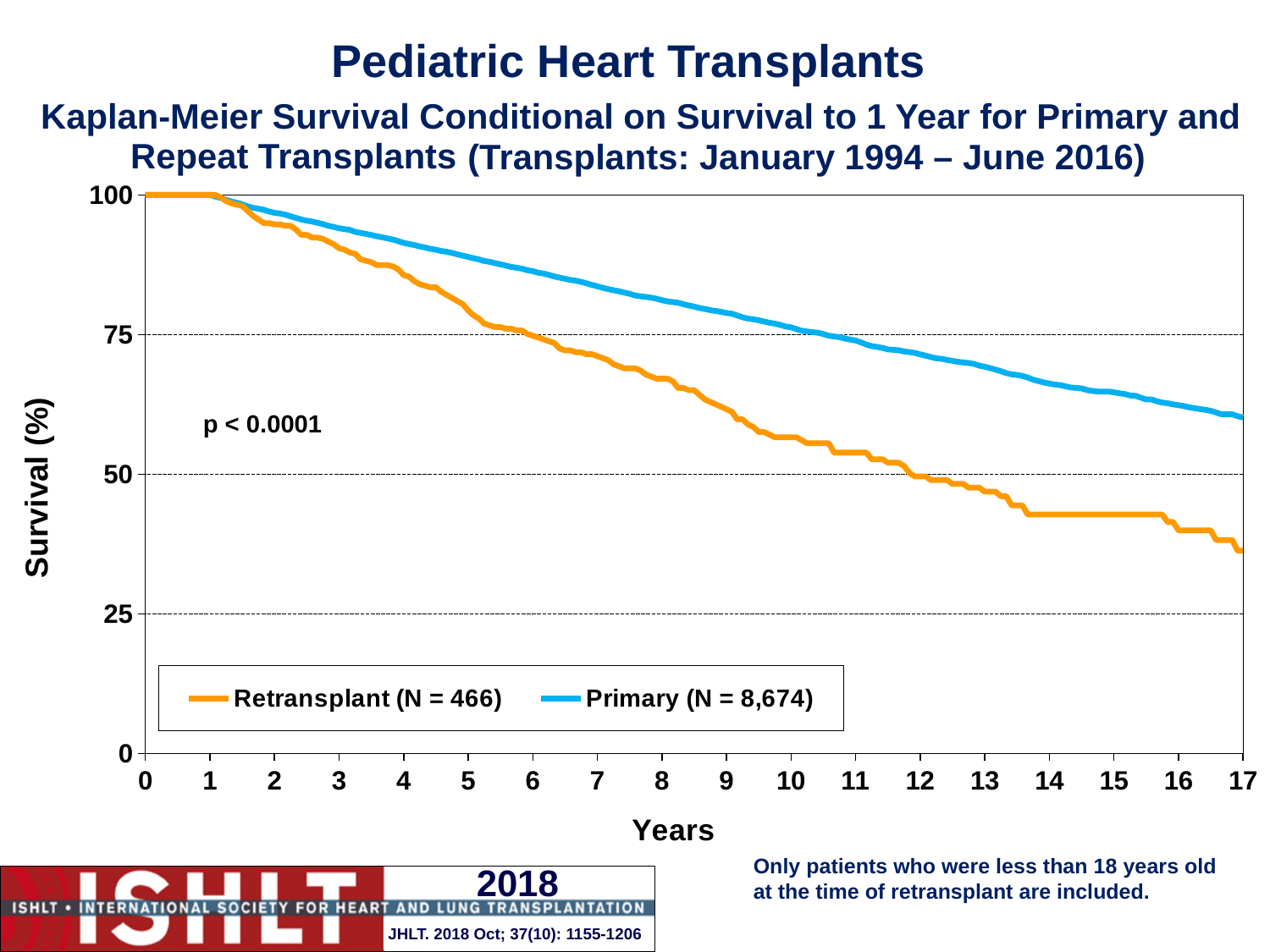
At year 10, which series has the higher survival value, Primary or Retransplant? Primary Is the survival value for the Primary series at year 5 greater or less than 75? greater What is the survival value for the Retransplant series at year 1? 100 What kind of chart is shown on the slide? line chart What p-value is printed on the chart? p < 0.0001 Is the survival value for the Retransplant series at year 10 greater or less than 75? less Is the survival value for the Retransplant series at year 14 greater or less than 50? less Do the survival values for the Retransplant series rise or fall as years increase? fall How many series does the legend list? 2 What is the survival value for the Primary series at year 0? 100